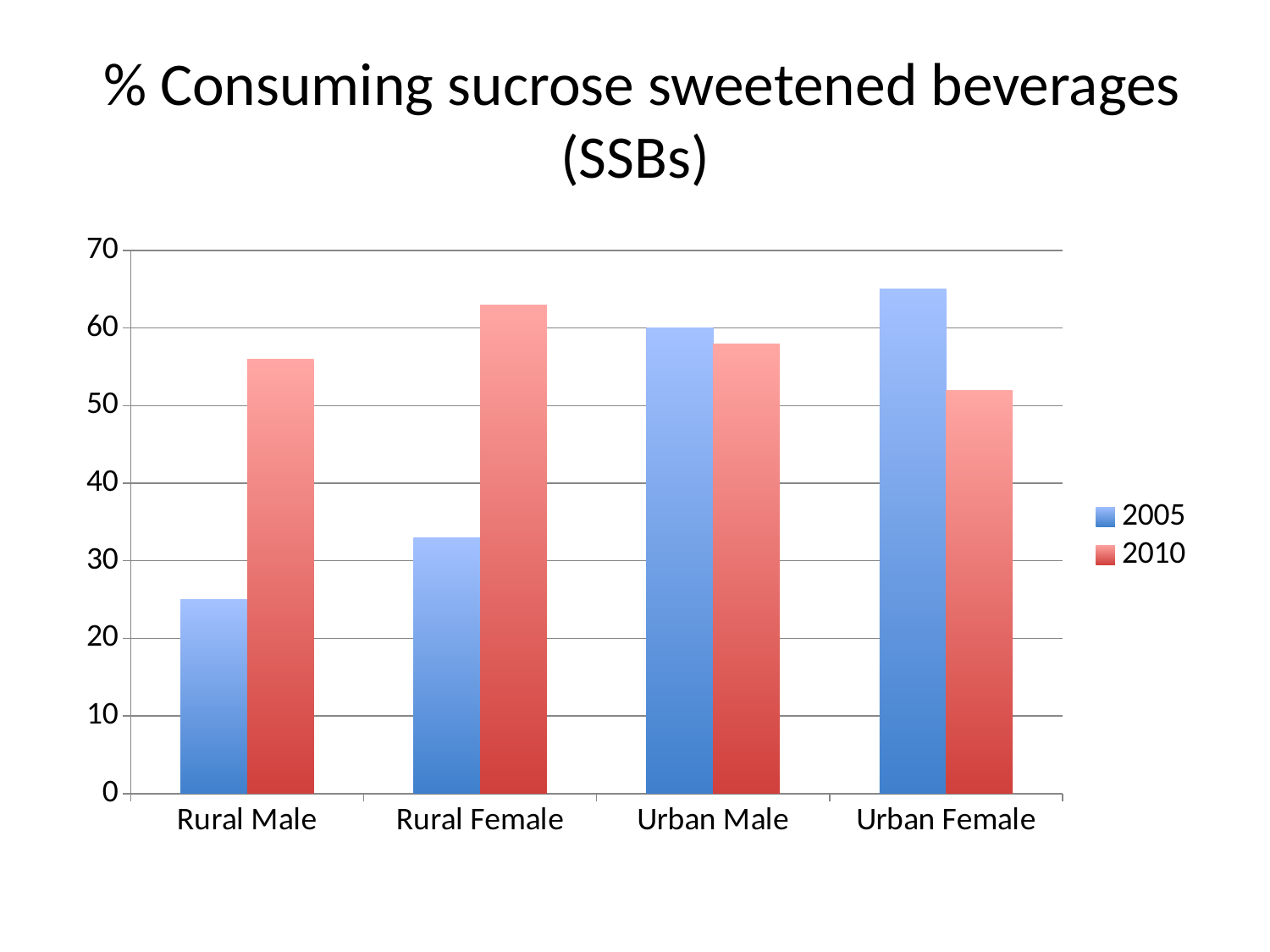
Which category has the highest value for the 2010 series? Rural Female How many categories are shown on the x axis? 4 For Rural Male, which series has the larger value, 2005 or 2010? 2010 Which series does the legend list first? 2005 Which category has the lowest value for the 2005 series? Rural Male Which category has the highest value for the 2005 series? Urban Female Is the 2005 value for Rural Male greater or less than 30? less For Urban Female, which series has the larger value, 2005 or 2010? 2005 What is the title of the chart? % Consuming sucrose sweetened beverages (SSBs) Which category has the lowest value for the 2010 series? Urban Female What kind of chart is shown on the slide? bar chart How many series does the legend list? 2